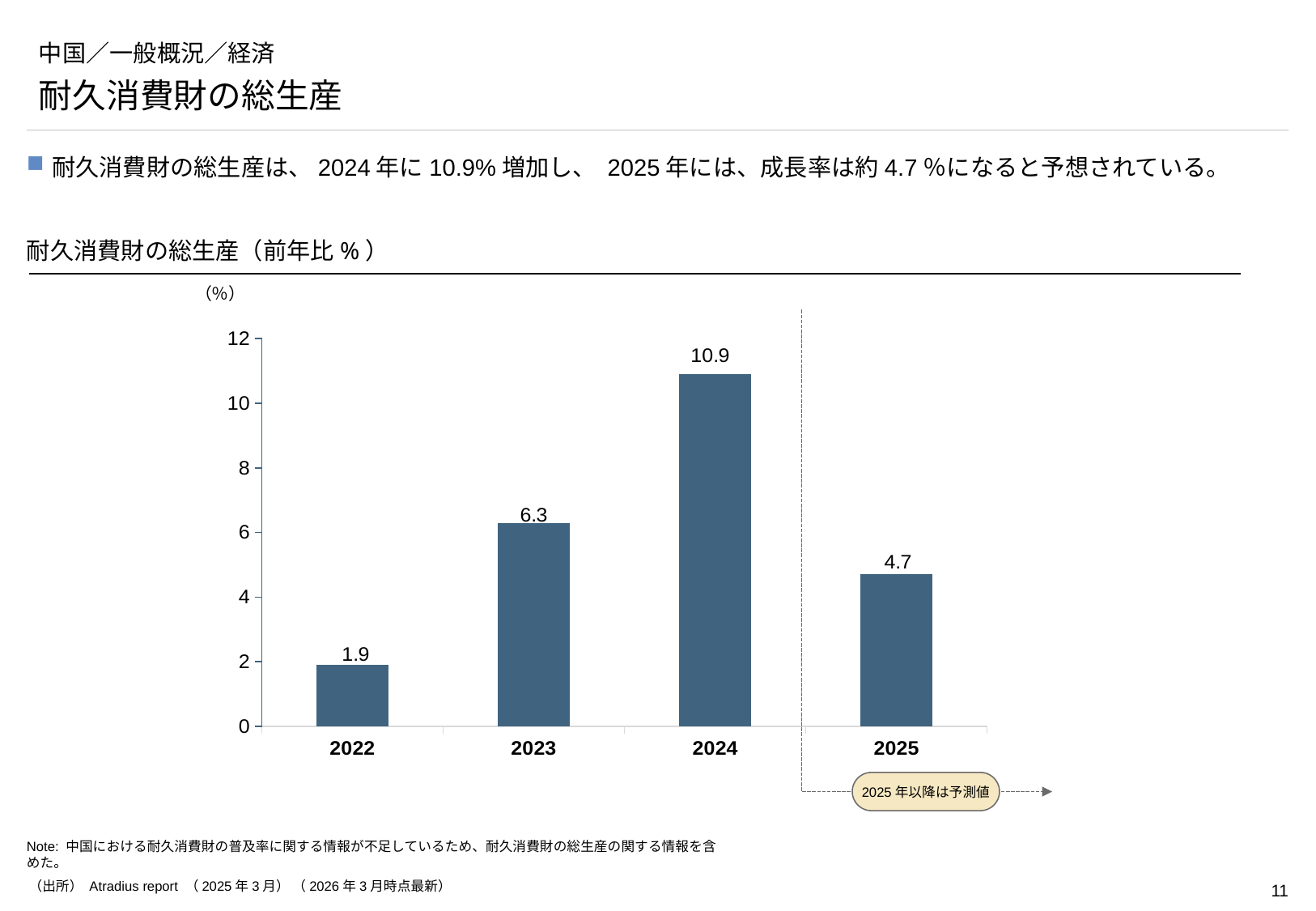
What is the difference between the values for 2024 and 2023? 4.6 Which is larger, the value for 2023 or the value for 2025? 2023 Is the value for 2023 greater or less than 6? greater What is the value for 2025? 4.7 Do the values rise or fall from 2022 to 2024? Rise What kind of chart is this? Bar chart How many years are shown on the x axis? 4 What is the value for 2024? 10.9 What is the value for 2022? 1.9 Which year has the lowest value? 2022 What is the unit shown on the y axis? % Which year has the highest value? 2024